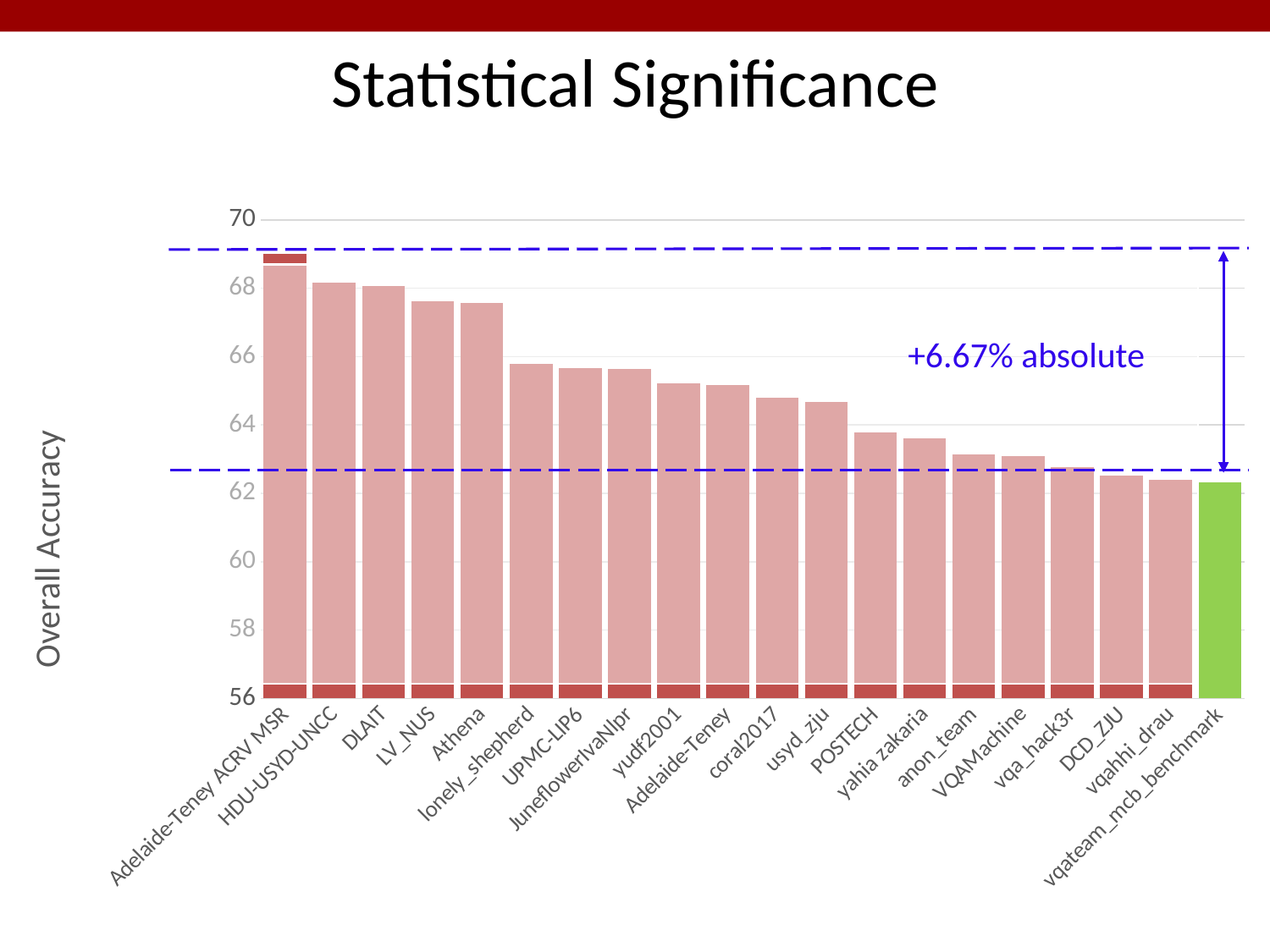
Is the value for LV_NUS greater or less than 68? less Is the value for vqateam_mcb_benchmark greater or less than 62? greater Which team has the lowest overall accuracy in the chart? vqateam_mcb_benchmark Which team has the highest overall accuracy in the chart? Adelaide-Teney ACRV MSR What absolute improvement does the annotation between the two dashed lines state? +6.67% absolute Which has a higher overall accuracy, Athena or POSTECH? Athena Is the value for lonely_shepherd greater or less than 66? less What kind of chart is shown on the slide? bar chart Do the bar values rise or fall from left to right along the x axis? fall How many teams (bars) are shown in the chart? 20